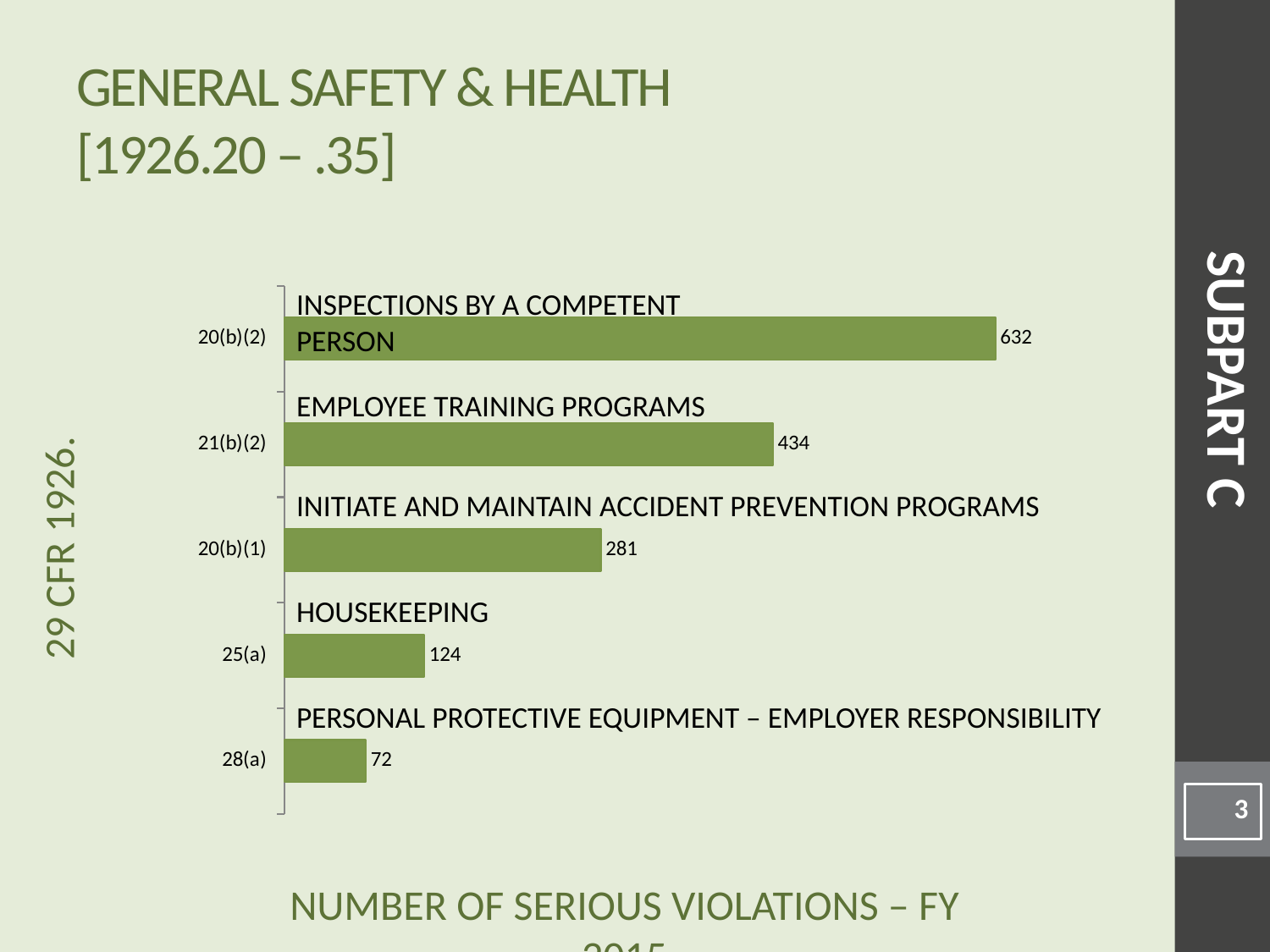
How many categories are shown in the chart? 5 What is the difference in serious violations between 20(b)(1) and 25(a)? 157 What is the number of serious violations for 20(b)(2), Inspections by a Competent Person? 632 What is the difference in serious violations between 20(b)(2) and 21(b)(2)? 198 Which category has the lowest number of serious violations? 28(a) Personal Protective Equipment – Employer Responsibility Which has more serious violations, 21(b)(2) Employee Training Programs or 20(b)(1) Initiate and Maintain Accident Prevention Programs? 21(b)(2) Employee Training Programs What is the number of serious violations for 28(a), Personal Protective Equipment – Employer Responsibility? 72 What is the number of serious violations for 21(b)(2), Employee Training Programs? 434 What kind of chart is shown on the slide? Bar chart What is the number of serious violations for 25(a), Housekeeping? 124 Which category has the highest number of serious violations? 20(b)(2) Inspections by a Competent Person What is the title of the slide? GENERAL SAFETY & HEALTH [1926.20 – .35]